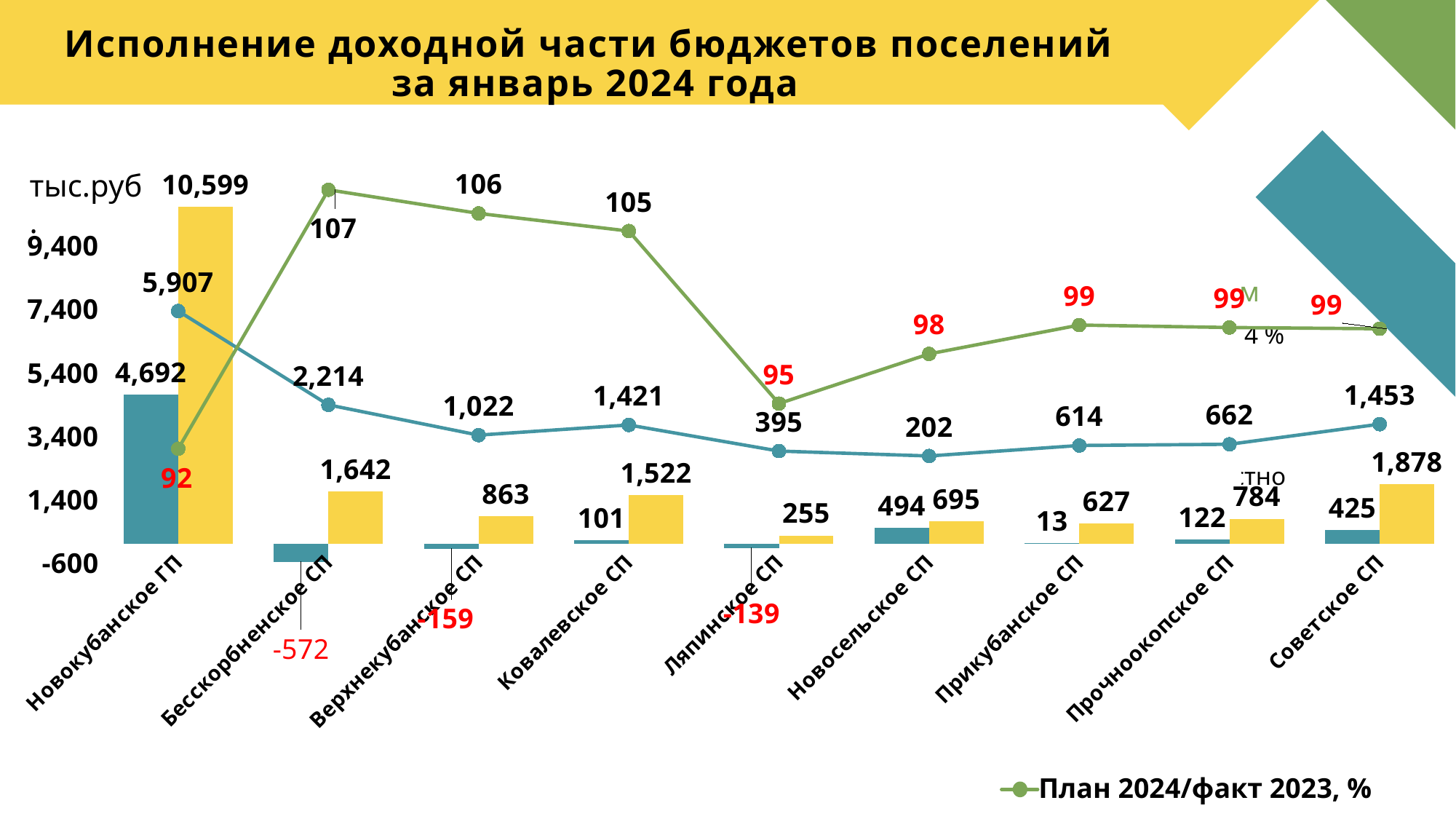
Which category has the highest value on the 'План 2024/факт 2023, %' line? Бесскорбненское СП Which category has the tallest yellow bar? Новокубанское ГП What is the value of the 'План 2024/факт 2023, %' line for Бесскорбненское СП? 107 How many categories (settlements) are shown on the x axis? 9 Does the 'План 2024/факт 2023, %' line rise or fall from Ляпинское СП to Новосельское СП? rise Which is larger: the yellow bar for Ковалевское СП or the yellow bar for Верхнекубанское СП? Ковалевское СП What is the value of the yellow bar for Советское СП? 1,878 What is the value of the teal bar for Бесскорбненское СП? -572 What unit is indicated in the top-left corner of the chart? тыс.руб What is the difference between the 'План 2024/факт 2023, %' values for Ковалевское СП and Ляпинское СП? 10 What is the value of the 'План 2024/факт 2023, %' line for Новокубанское ГП? 92 Which category has the lowest value on the 'План 2024/факт 2023, %' line? Новокубанское ГП